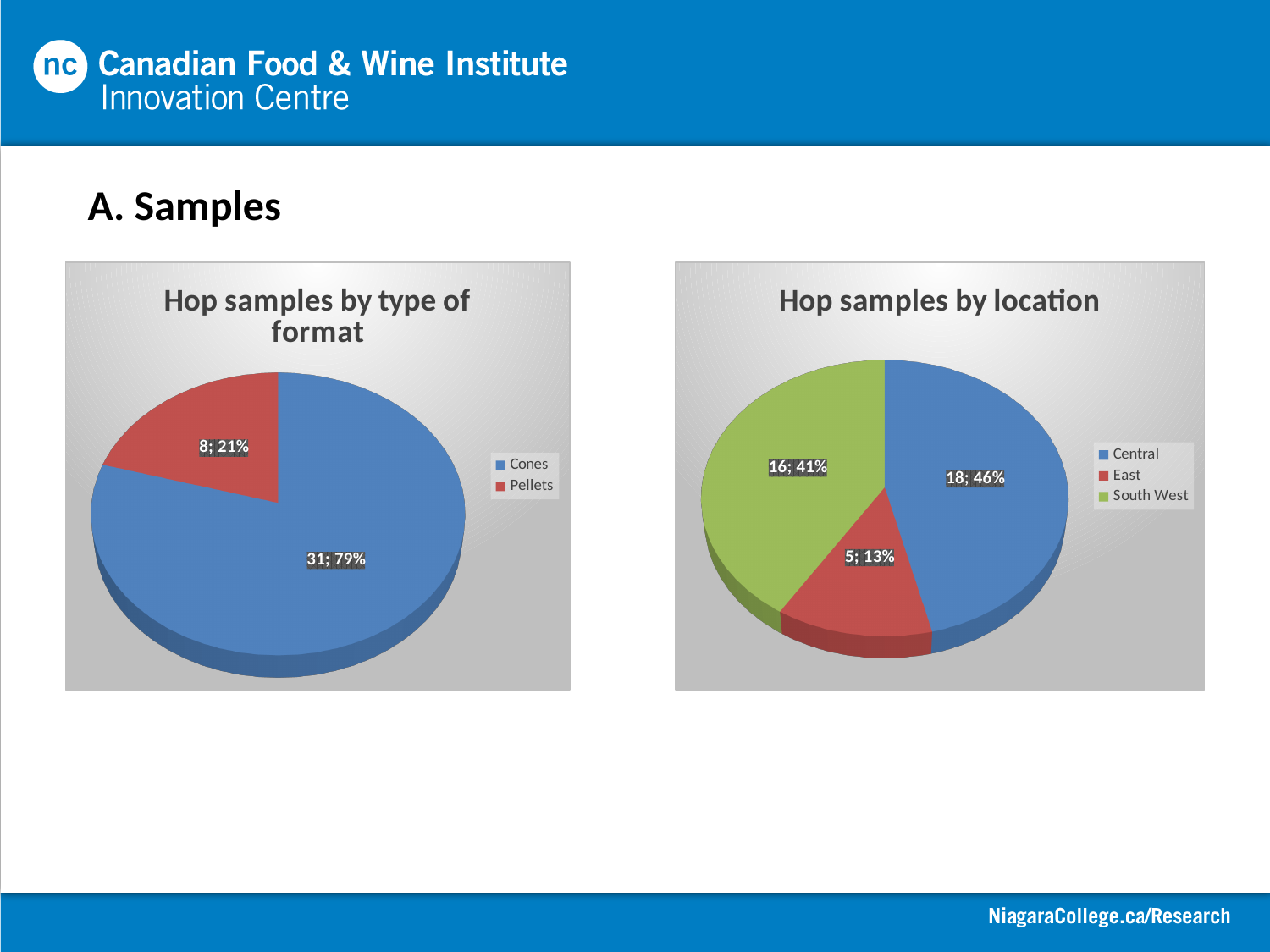
In the 'Hop samples by location' chart, which location has the fewest samples? East In the 'Hop samples by location' chart, what share of the pie is East? 13% In the 'Hop samples by type of format' chart, which format has the most samples? Cones In the 'Hop samples by type of format' chart, what is the difference between the number of Cones samples and Pellets samples? 23 In the 'Hop samples by location' chart, which colour represents South West? Green In the 'Hop samples by type of format' chart, what share of the pie is Pellets? 21% In the 'Hop samples by location' chart, which has more samples, Central or South West? Central In the 'Hop samples by type of format' chart, how many samples are Cones? 31 In the 'Hop samples by location' chart, what is the total number of samples across all locations? 39 In the 'Hop samples by type of format' chart, how many categories does the legend list? 2 In the 'Hop samples by location' chart, how many samples come from South West? 16 What kind of chart is 'Hop samples by type of format'? Pie chart